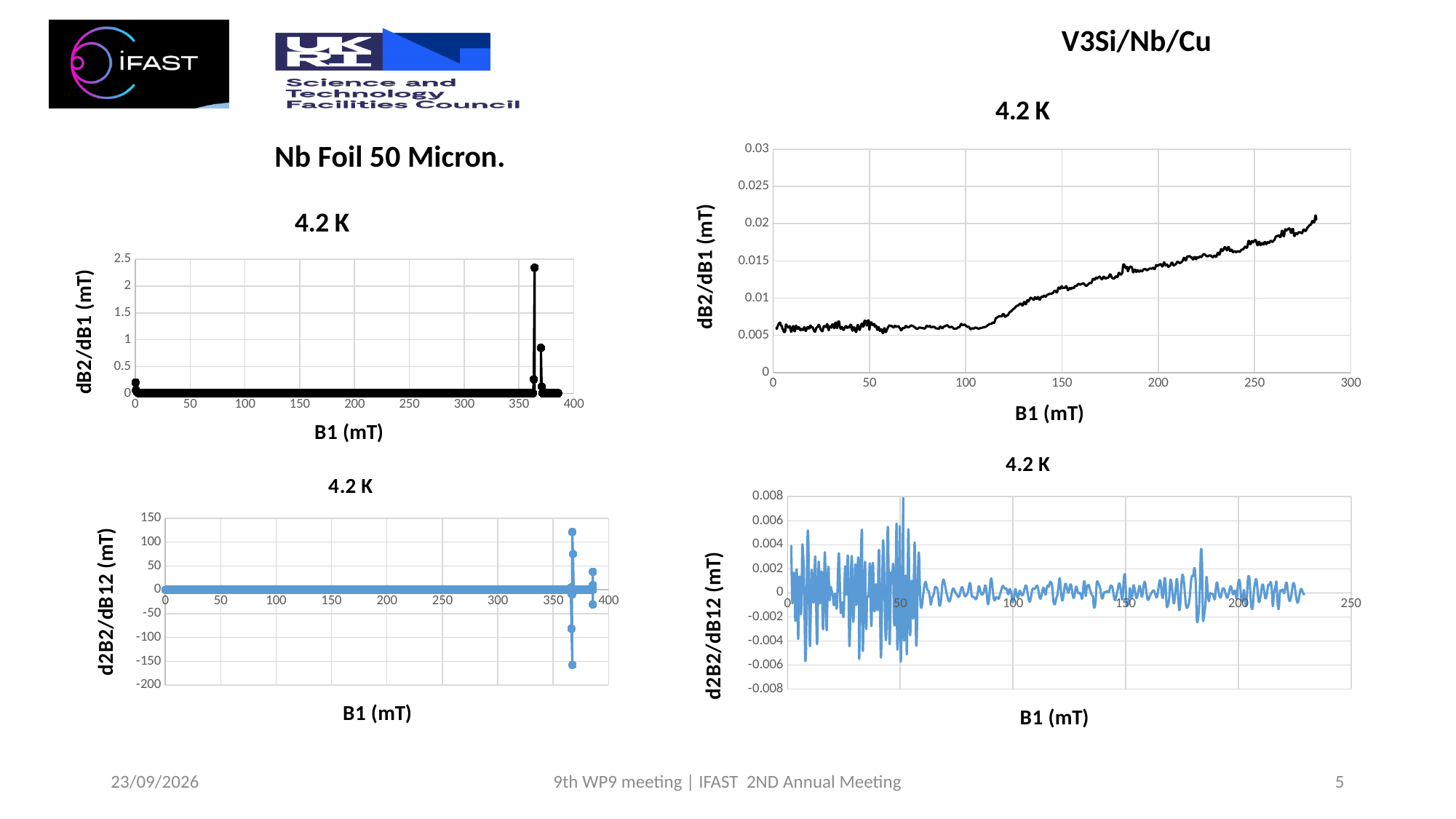
What is the highest tick value on the x axis of the bottom-right chart (V3Si/Nb/Cu, d2B2/dB12)? 250 In the top-left chart (Nb Foil 50 Micron, dB2/dB1), is the highest peak value greater or less than 2? greater In the bottom-left chart (Nb Foil 50 Micron, d2B2/dB12), is the highest peak value greater or less than 100? greater In the top-left chart (Nb Foil 50 Micron, dB2/dB1), what is the label of the x axis? B1 (mT) In the top-right chart (V3Si/Nb/Cu, dB2/dB1), is the value at B1 = 250 mT greater or less than 0.015? greater In the top-right chart (V3Si/Nb/Cu, dB2/dB1), what is the label of the y axis? dB2/dB1 (mT) In the top-right chart (V3Si/Nb/Cu, dB2/dB1), do the values generally rise or fall as B1 increases from 100 mT to 280 mT? rise How many charts are shown on the slide? 4 In the top-right chart (V3Si/Nb/Cu, dB2/dB1), is the value at B1 = 250 mT larger or smaller than the value at B1 = 50 mT? larger